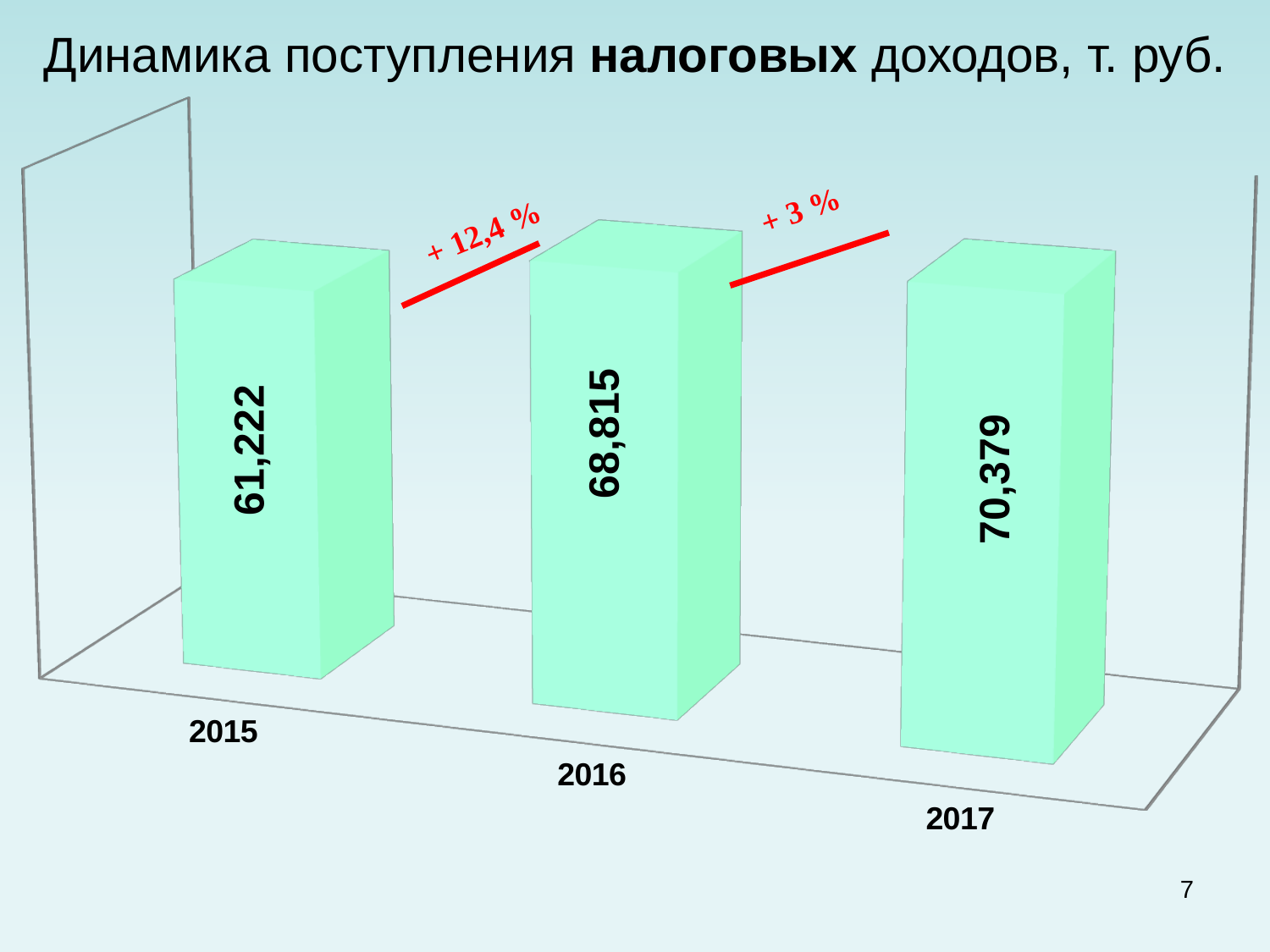
What is the difference between the values for 2016 and 2015? 7,593 Which is larger, the value for 2015 or the value for 2016? 2016 Which year has the lowest value? 2015 Which year has the highest value? 2017 Do the values rise or fall from 2015 to 2017? Rise What is the difference between the values for 2017 and 2016? 1,564 What percentage change is annotated between the 2015 and 2016 bars? + 12,4 % How many years are shown on the chart? 3 What kind of chart is shown on the slide? Bar chart What is the value for 2015? 61,222 What is the value for 2017? 70,379 What is the value for 2016? 68,815